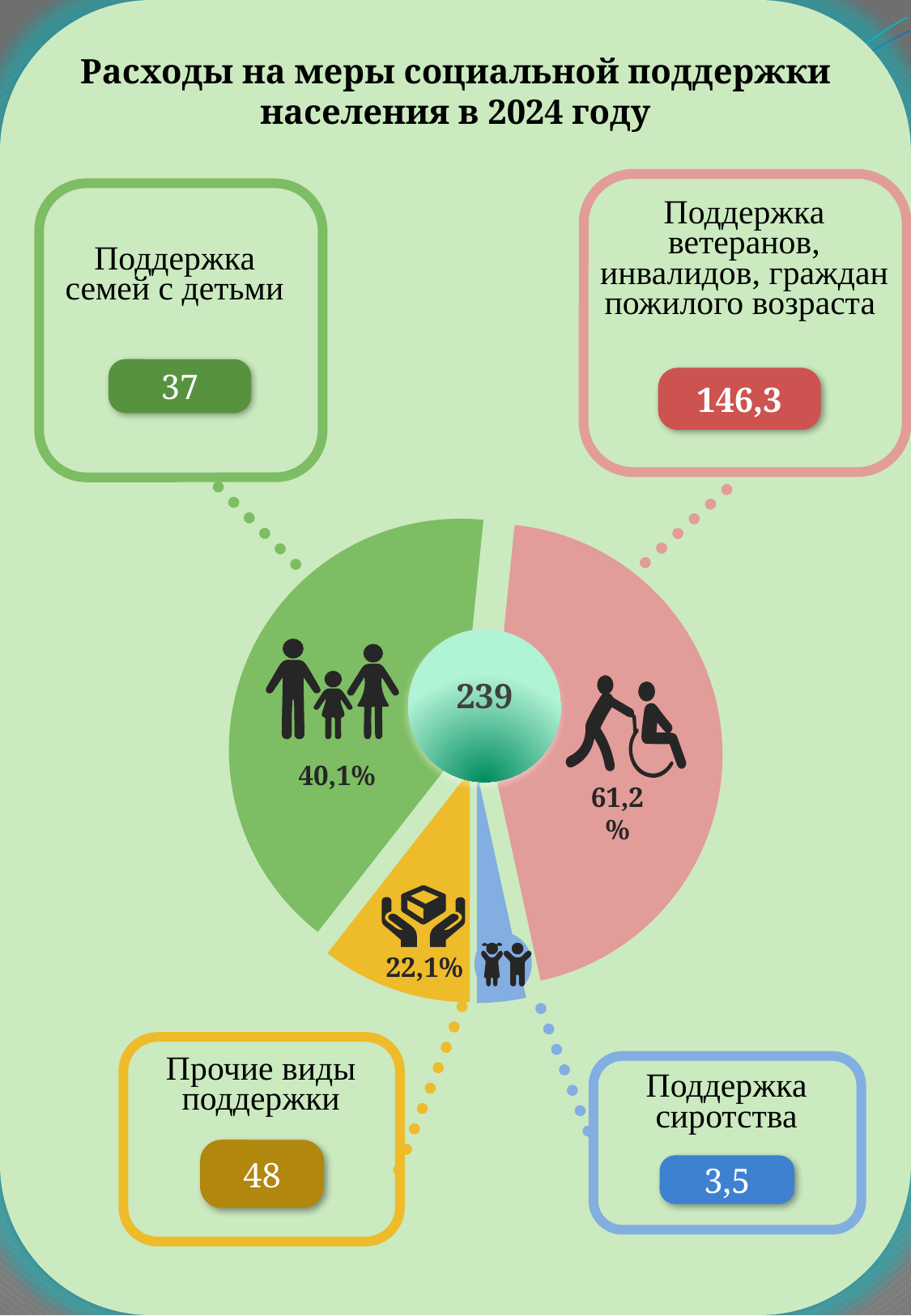
Which is larger, the value for "Прочие виды поддержки" or the value for "Поддержка семей с детьми"? Прочие виды поддержки What value is shown for "Поддержка сиротства"? 3,5 What number is shown in the centre of the pie chart? 239 Which category has the largest value? Поддержка ветеранов, инвалидов, граждан пожилого возраста What value is shown for "Поддержка семей с детьми"? 37 Which category has the smallest value? Поддержка сиротства What value is shown for "Поддержка ветеранов, инвалидов, граждан пожилого возраста"? 146,3 What kind of chart is shown on the slide? pie chart What value is shown for "Прочие виды поддержки"? 48 How many slices does the pie chart have? 4 What is the difference between the values for "Прочие виды поддержки" and "Поддержка семей с детьми"? 11 What percentage label is printed on the pink slice of the pie chart? 61,2%